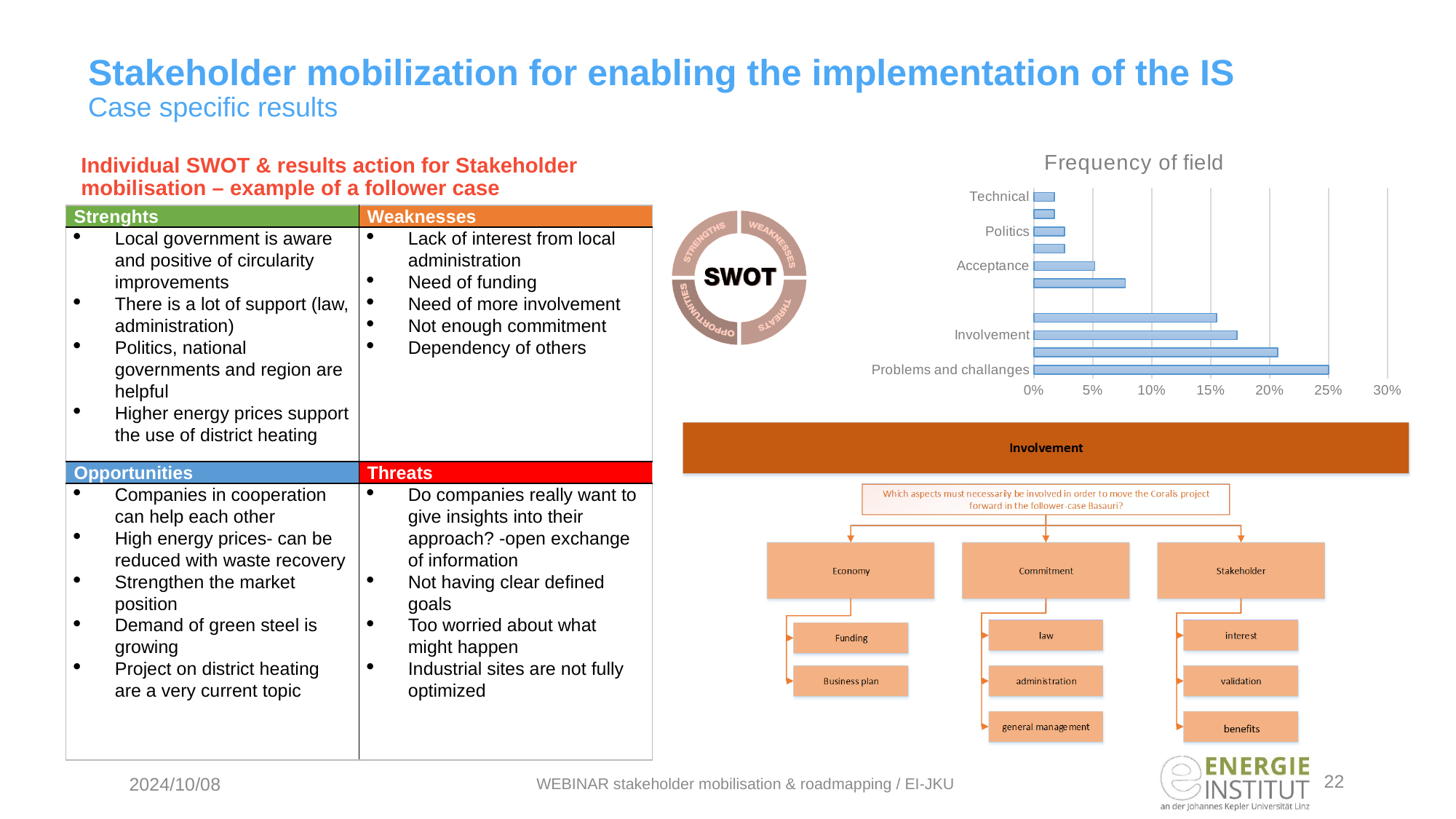
In the 'Frequency of field' chart, which is larger, the value for Involvement or the value for Problems and challanges? Problems and challanges What is the highest value shown on the horizontal axis of the 'Frequency of field' chart? 30% What kind of chart is the 'Frequency of field' chart? bar chart In the 'Frequency of field' chart, which labeled category has the longest bar? Problems and challanges In the 'Frequency of field' chart, is the value for Technical greater or less than 5%? less What is the title of the bar chart on the slide? Frequency of field In the 'Frequency of field' chart, which is larger, the value for Acceptance or the value for Politics? Acceptance In the 'Frequency of field' chart, is the value for Problems and challanges greater or less than 20%? greater In the 'Frequency of field' chart, is the value for Involvement greater or less than 15%? greater How many category labels are shown on the vertical axis of the 'Frequency of field' chart? 5